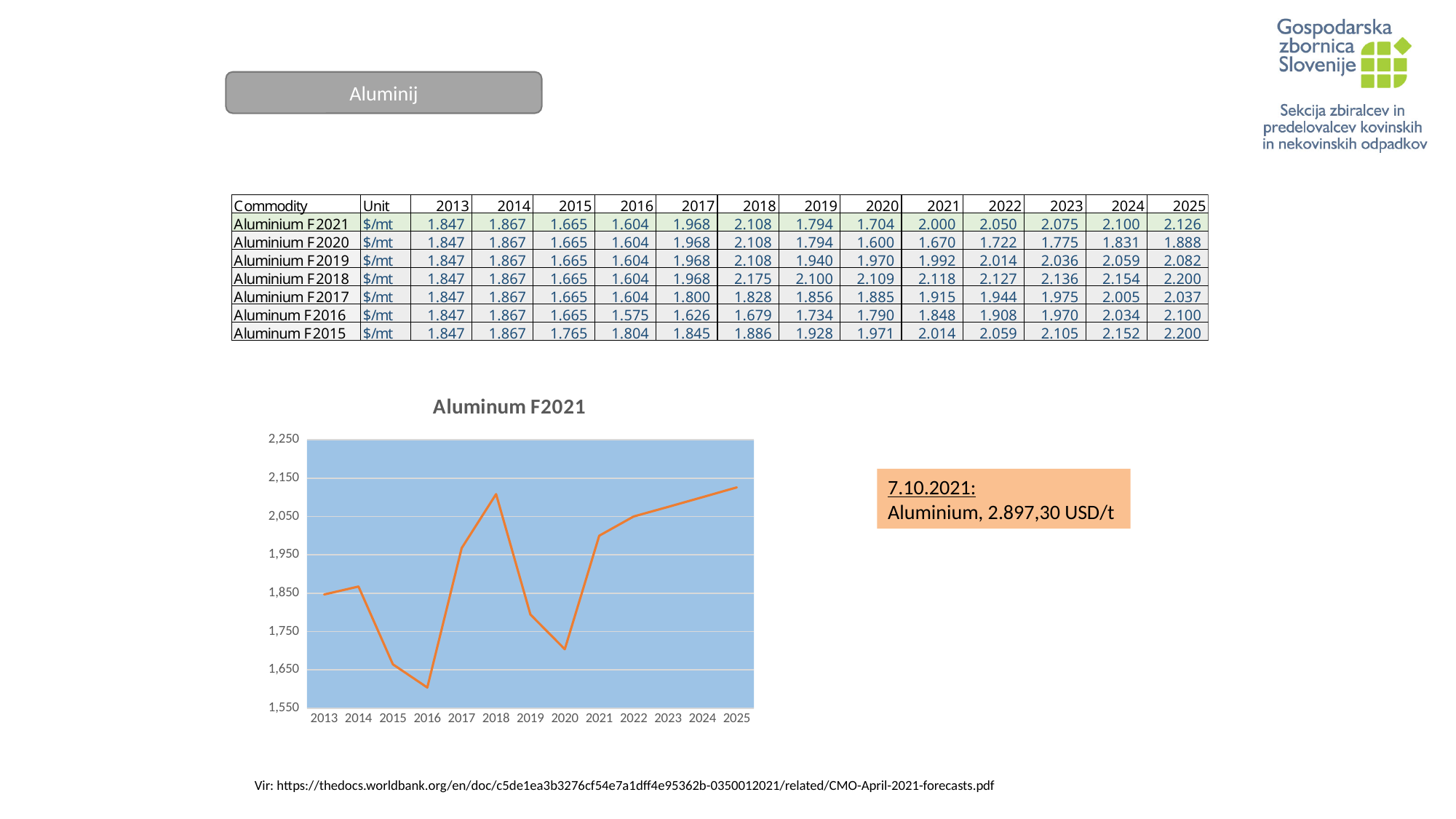
How many years are plotted along the x axis of the chart? 13 Which year has the higher value on the chart, 2018 or 2019? 2018 Is the value for 2020 on the chart greater or less than 1,750? less According to the Aluminium F2021 row of the table, what is the value for 2025 in $/mt? 2.126 What type of chart is shown on the slide? line chart Is the value for 2016 on the chart greater or less than 1,650? less What colour is the line in the chart? orange Is the value for 2018 on the chart greater or less than 2,050? greater In which year does the Aluminum F2021 line reach its lowest value? 2016 What is the title of the chart? Aluminum F2021 Does the line rise or fall from 2021 to 2025? rise